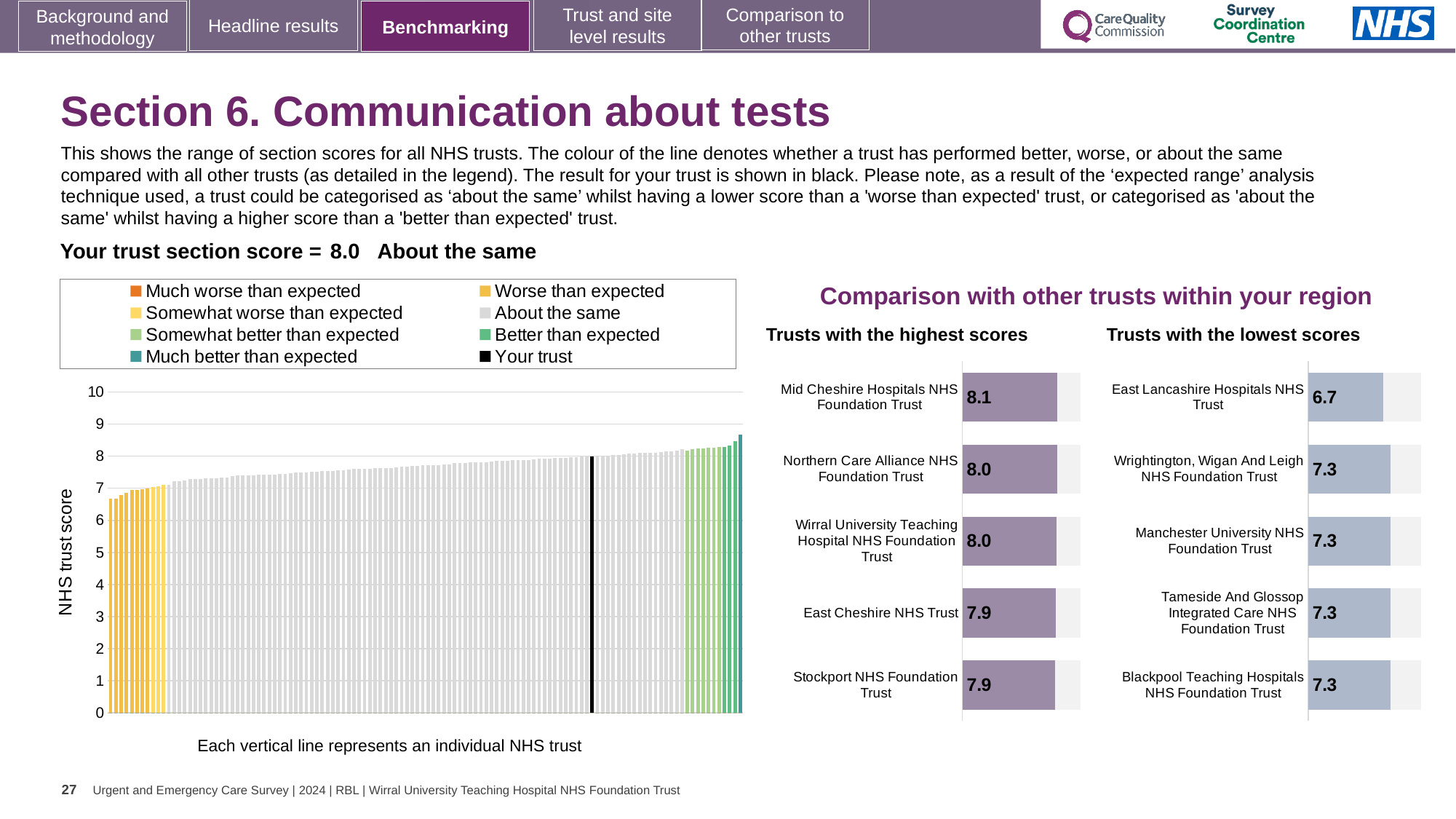
How many entries does the legend of the main benchmarking chart on the left list? 8 In the 'Trusts with the highest scores' chart, what is the score for Mid Cheshire Hospitals NHS Foundation Trust? 8.1 In the 'Trusts with the highest scores' chart, which trust has the highest score? Mid Cheshire Hospitals NHS Foundation Trust In the 'Trusts with the lowest scores' chart, which trust has the lowest score? East Lancashire Hospitals NHS Trust In the 'Trusts with the lowest scores' chart, what is the score for East Lancashire Hospitals NHS Trust? 6.7 In the 'Trusts with the highest scores' chart, what is the score for East Cheshire NHS Trust? 7.9 In the main benchmarking chart on the left, do the values rise or fall from left to right along the x axis? Rise In the 'Trusts with the highest scores' chart, which has the larger score: Mid Cheshire Hospitals NHS Foundation Trust or Stockport NHS Foundation Trust? Mid Cheshire Hospitals NHS Foundation Trust How many trusts are shown in the 'Trusts with the lowest scores' chart? 5 What kind of chart is the main benchmarking chart on the left of the slide? Bar chart What is the difference between the score for Mid Cheshire Hospitals NHS Foundation Trust in the highest scores chart and the score for East Lancashire Hospitals NHS Trust in the lowest scores chart? 1.4 In the 'Trusts with the lowest scores' chart, what is the score for Blackpool Teaching Hospitals NHS Foundation Trust? 7.3